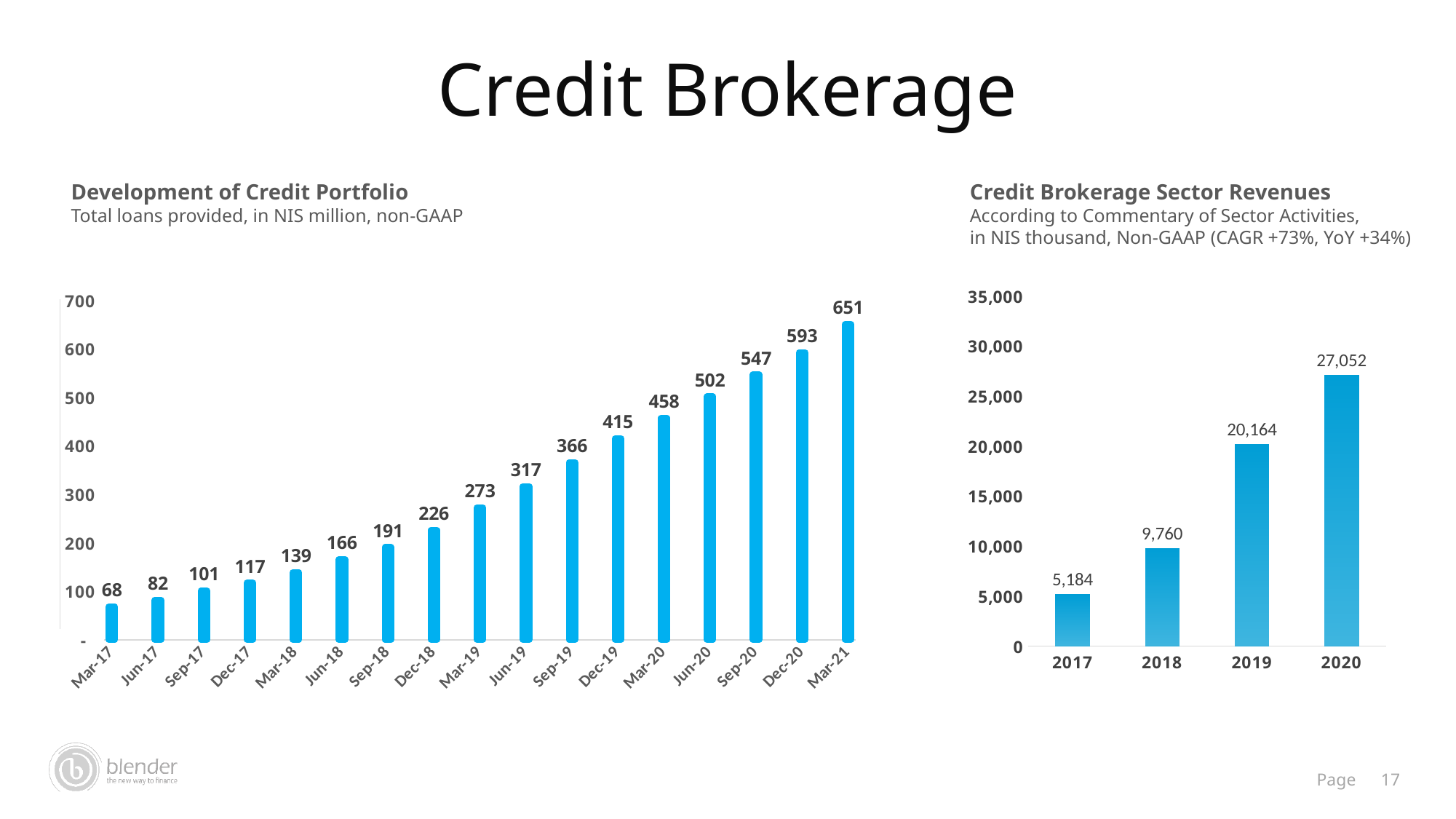
In the 'Development of Credit Portfolio' chart, what is the value for Mar-21? 651 In the 'Credit Brokerage Sector Revenues' chart, what is the value for 2019? 20,164 In the 'Development of Credit Portfolio' chart, which period has the lowest value? Mar-17 What kind of chart is the 'Credit Brokerage Sector Revenues' chart? bar chart In the 'Credit Brokerage Sector Revenues' chart, how many years are shown? 4 In the 'Development of Credit Portfolio' chart, do the values rise or fall from Mar-17 to Mar-21? rise In the 'Credit Brokerage Sector Revenues' chart, which year has the highest value? 2020 In the 'Credit Brokerage Sector Revenues' chart, what is the difference between the values for 2018 and 2017? 4,576 In the 'Development of Credit Portfolio' chart, what is the difference between the values for Mar-21 and Dec-20? 58 In the 'Development of Credit Portfolio' chart, which is larger, the value for Jun-19 or the value for Sep-19? Sep-19 In the 'Development of Credit Portfolio' chart, what is the value for Dec-18? 226 In the 'Development of Credit Portfolio' chart, how many periods are shown on the x axis? 17